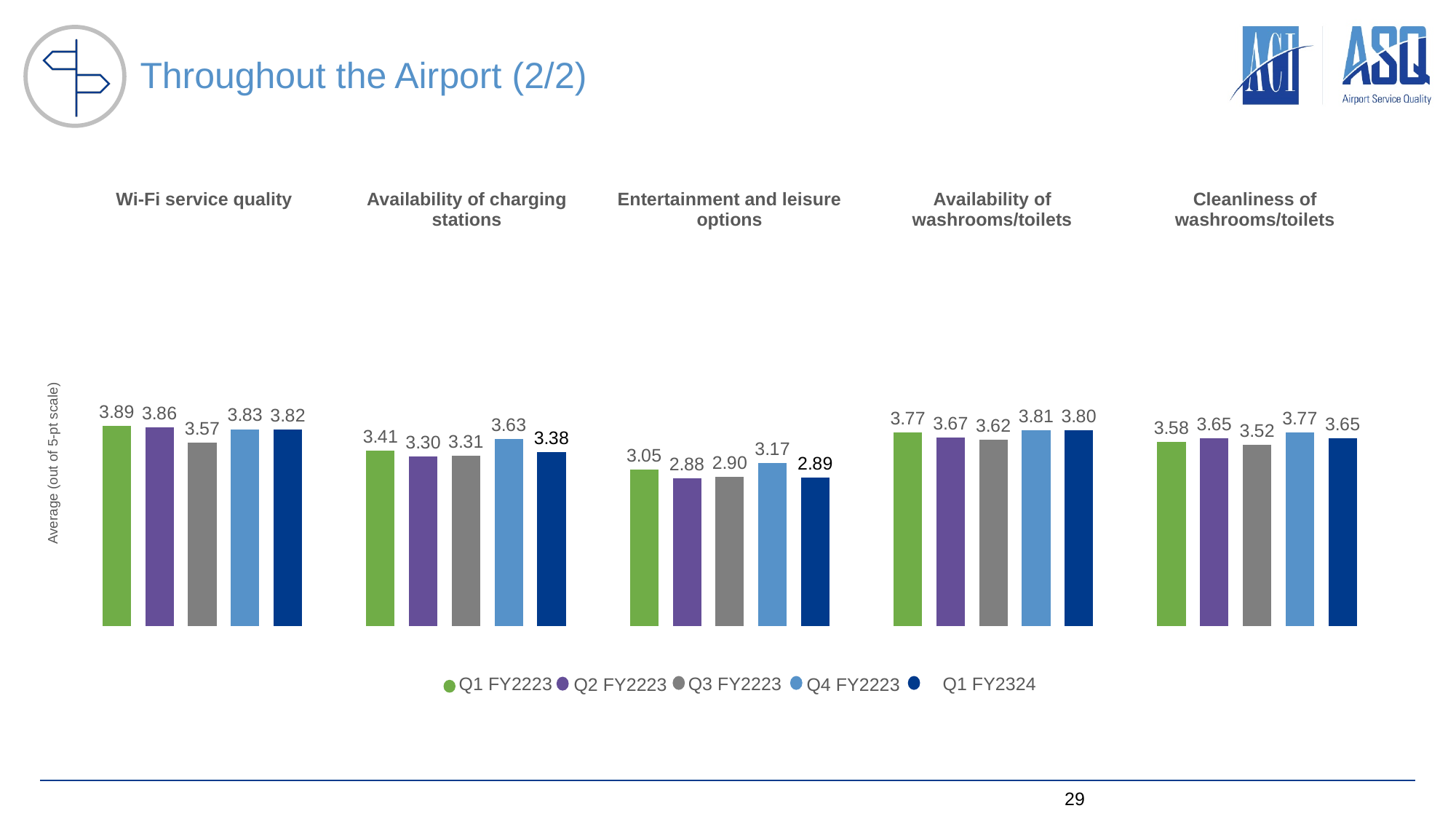
What is the difference between the Q1 FY2223 and Q3 FY2223 values for Wi-Fi service quality? 0.32 Which is larger in Q4 FY2223: Availability of washrooms/toilets or Cleanliness of washrooms/toilets? Availability of washrooms/toilets What kind of chart is shown on the slide? Bar chart What is the Q4 FY2223 value for Availability of charging stations? 3.63 Did the value for Entertainment and leisure options rise or fall from Q1 FY2223 to Q1 FY2324? Fall What is the Q1 FY2324 value for Wi-Fi service quality? 3.82 Which quarter has the lowest value for Entertainment and leisure options? Q2 FY2223 What is the Q2 FY2223 value for Entertainment and leisure options? 2.88 Which category has the highest Q1 FY2324 value? Wi-Fi service quality How many series does the legend list? 5 How many categories are shown on the chart? 5 What is the label on the vertical axis of the chart? Average (out of 5-pt scale)